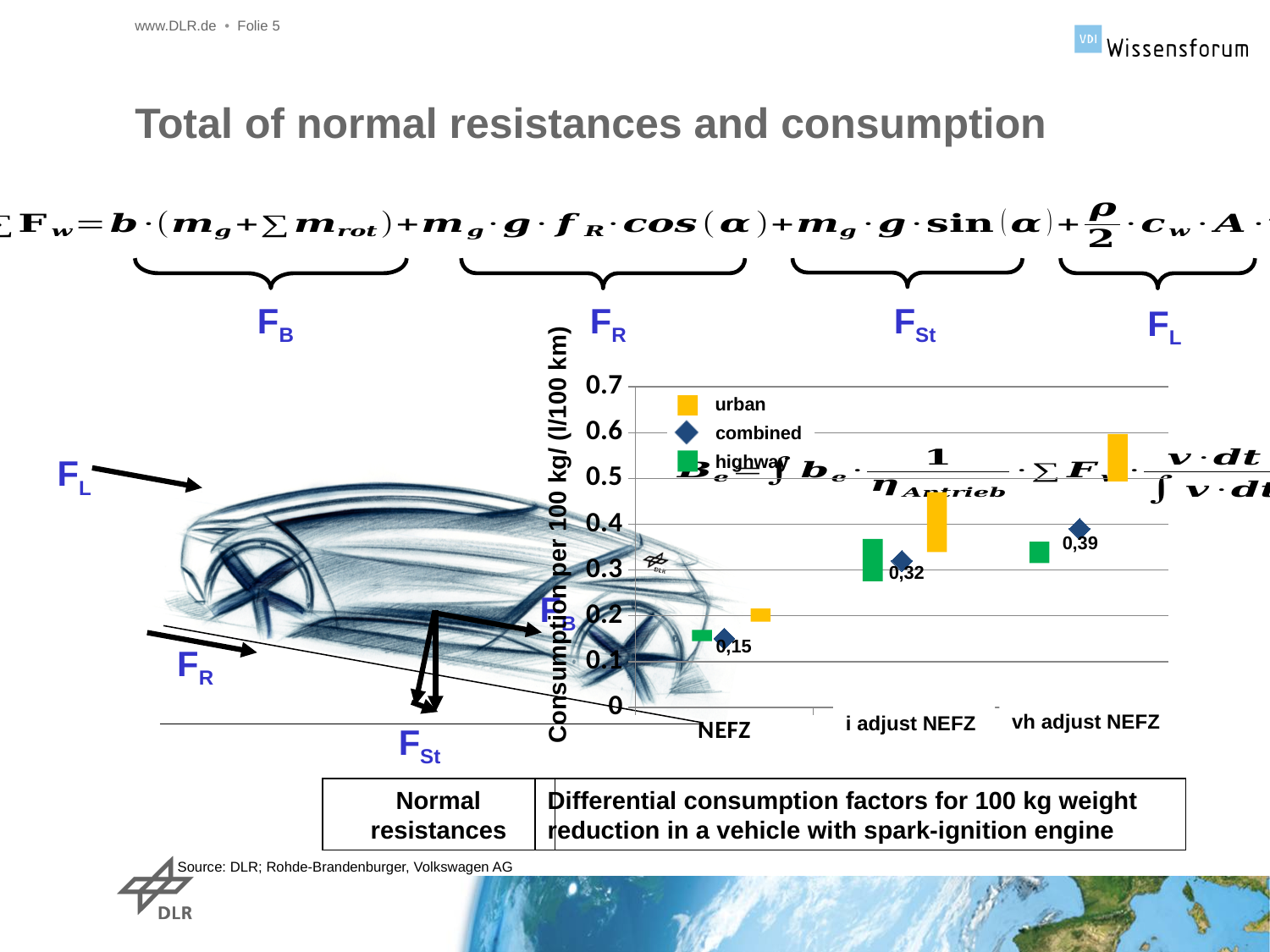
What is the combined value for i adjust NEFZ? 0,32 What is the combined value for NEFZ? 0,15 Which category has the highest combined value? vh adjust NEFZ Which is larger, the combined value for i adjust NEFZ or for vh adjust NEFZ? vh adjust NEFZ How many series does the legend list? 3 What is the combined value for vh adjust NEFZ? 0,39 Which category has the lowest combined value? NEFZ Do the combined values rise or fall from NEFZ to vh adjust NEFZ? rise What is the difference between the combined values for vh adjust NEFZ and NEFZ? 0,24 How many categories are shown on the x axis? 3 Is the urban value for vh adjust NEFZ greater or less than 0.4? greater What is the label of the y axis? Consumption per 100 kg/ (l/100 km)